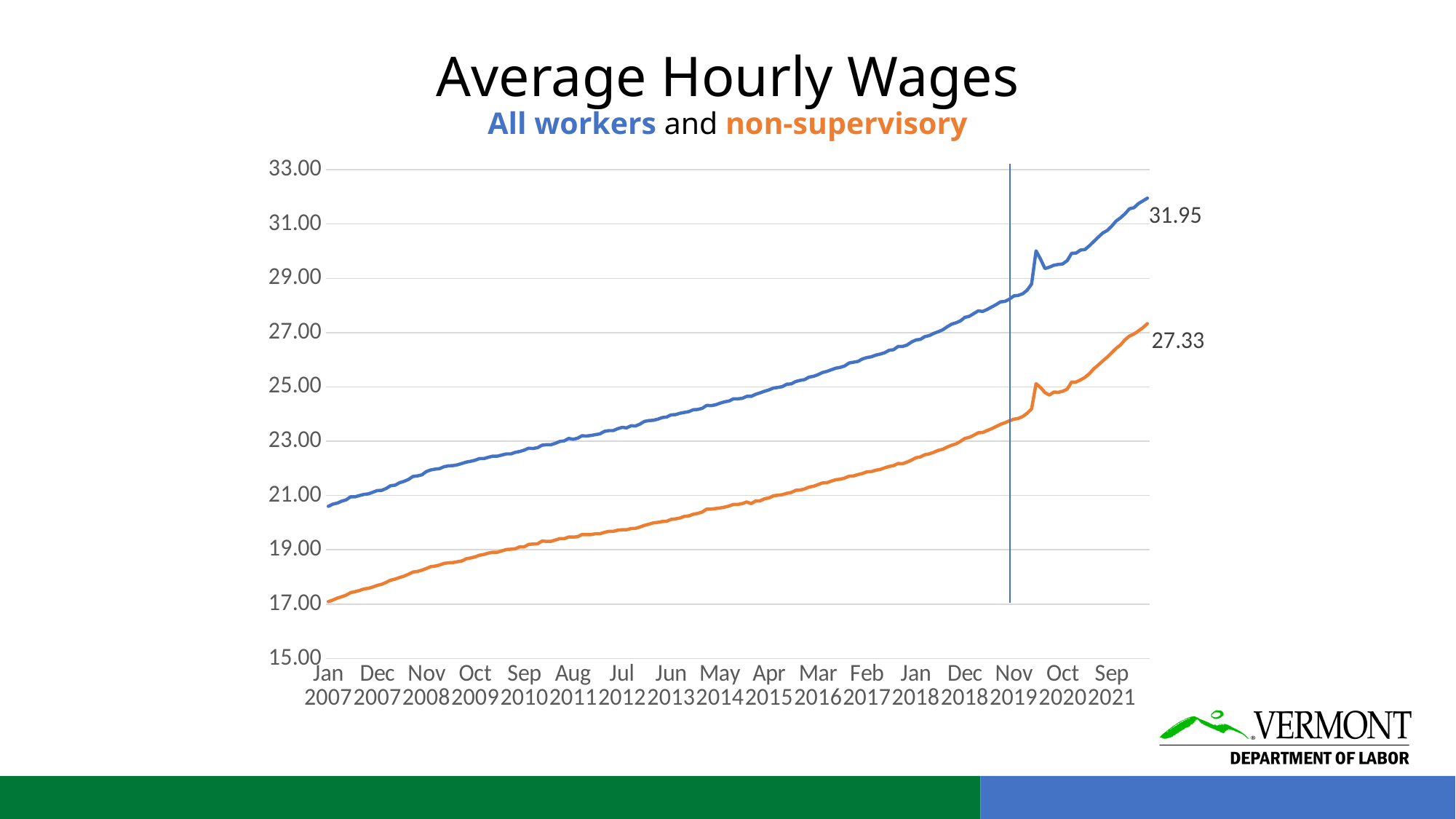
Which series has the higher final labelled value, All workers or non-supervisory? All workers Is the value for All workers at the vertical line in Nov 2019 greater or less than 29.00? less Is the value for non-supervisory workers in Jan 2018 greater or less than 21.00? greater How many data series are plotted on the chart? 2 What is the final labelled value for the All workers series? 31.95 Is the value for All workers in Jan 2007 greater or less than 21.00? less Do the average hourly wages rise or fall from Jan 2007 to Sep 2021? rise What kind of chart is shown on the slide? line chart What is the final labelled value for the non-supervisory series? 27.33 What is the difference between the final labelled values of the All workers and non-supervisory series? 4.62 What colour is the line for the non-supervisory series? orange What is the title of the chart? Average Hourly Wages